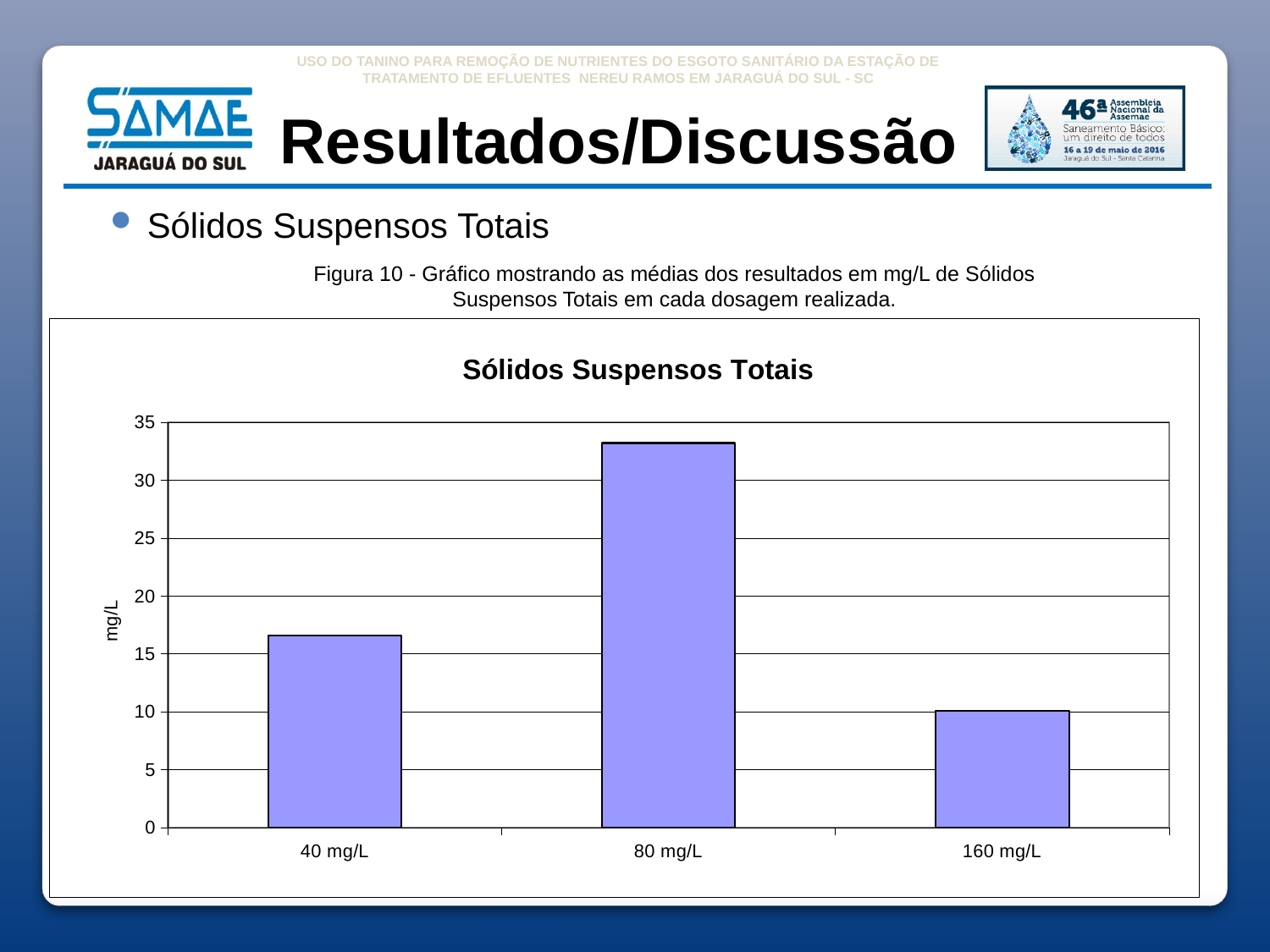
Is the value for 40 mg/L greater or less than 20? less Which dosage has the highest value for Sólidos Suspensos Totais? 80 mg/L Is the value for 160 mg/L greater or less than 15? less Which is larger, the value for 80 mg/L or the value for 40 mg/L? 80 mg/L Is the value for 80 mg/L greater or less than 30? greater Which dosage has the lowest value for Sólidos Suspensos Totais? 160 mg/L How many categories (dosages) are plotted on the x axis of the chart? 3 What is the title of the chart? Sólidos Suspensos Totais What is the label of the y axis of the chart? mg/L Which is larger, the value for 40 mg/L or the value for 160 mg/L? 40 mg/L What kind of chart is shown on the slide? bar chart